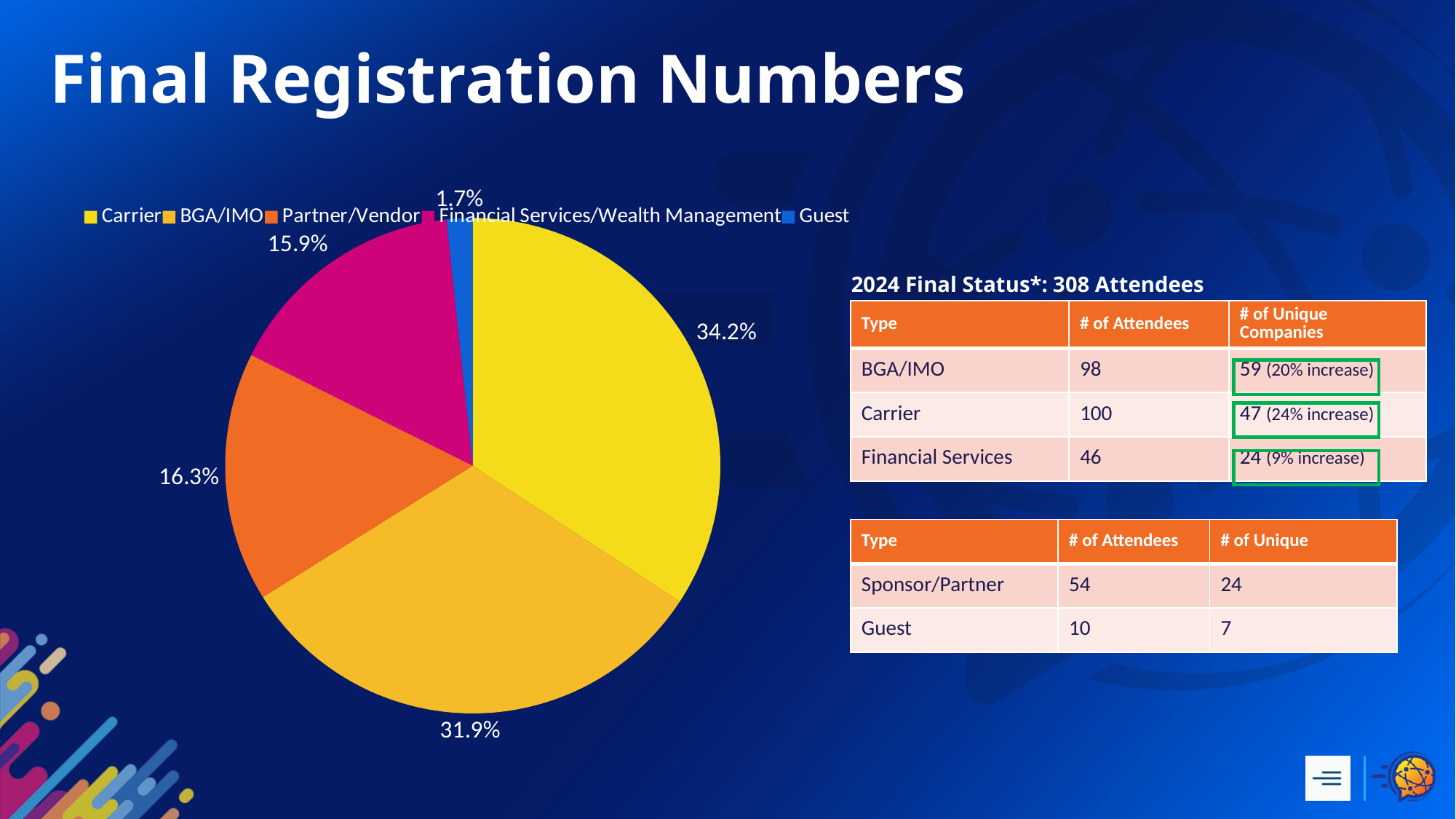
What colour is the Carrier slice in the pie chart? yellow What kind of chart is shown on the slide? pie chart What share of the pie does Partner/Vendor represent? 16.3% What share of the pie does Carrier represent? 34.2% Which category has the smallest slice of the pie? Guest What share of the pie does Guest represent? 1.7% Which category has the largest slice of the pie? Carrier How many categories does the pie chart legend list? 5 What is the difference in percentage points between the Carrier slice and the BGA/IMO slice? 2.3% Which slice is larger, Partner/Vendor or Guest? Partner/Vendor